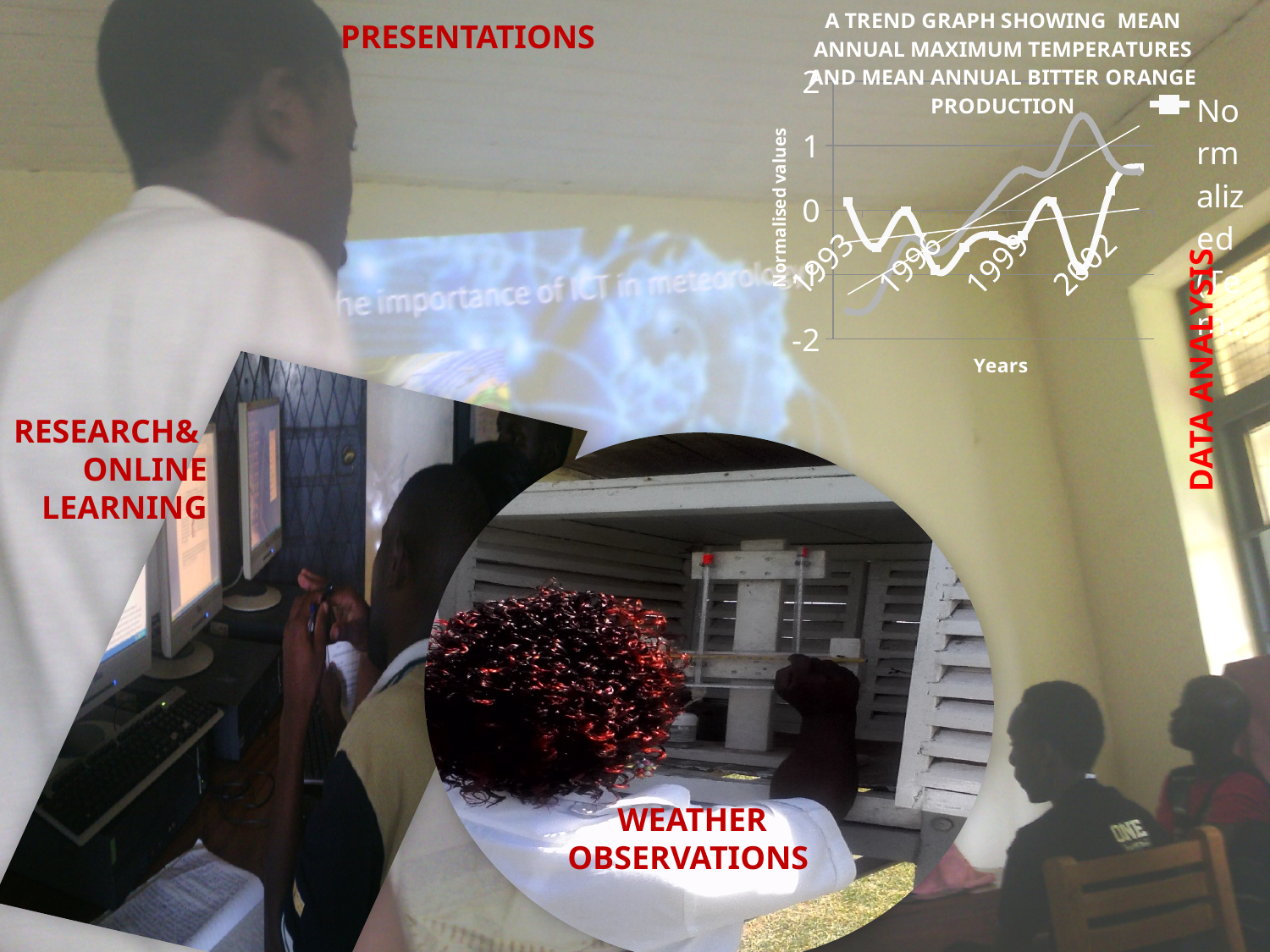
How many year labels are shown on the horizontal axis of the chart? 4 What kind of chart is shown on the slide? line chart What is the label of the vertical axis of the chart? Normalised values What is the label of the horizontal axis of the chart? Years What is the title of the chart on the slide? A TREND GRAPH SHOWING MEAN ANNUAL MAXIMUM TEMPERATURES AND MEAN ANNUAL BITTER ORANGE PRODUCTION What is the lowest value shown on the vertical axis of the chart? -2 What is the highest value shown on the vertical axis of the chart? 2 Do the plotted lines in the chart generally rise or fall from 1993 to 2002? rise What is the first year shown on the horizontal axis of the chart? 1993 What is the last year labelled on the horizontal axis of the chart? 2002 Is the peak value of the thicker line in the chart greater or less than 1? greater